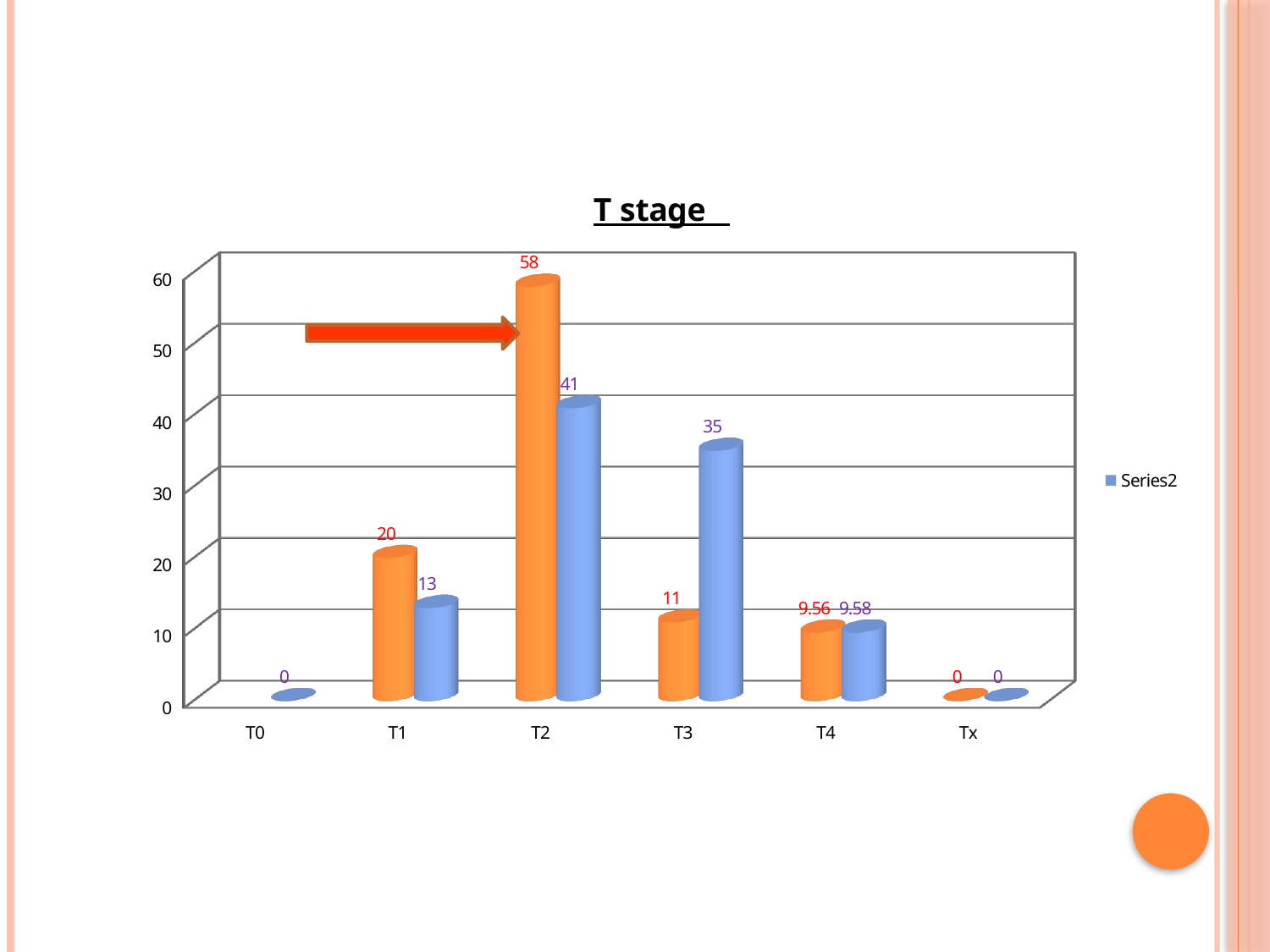
What is the value of the orange bar for T1? 20 Is the value of the orange bar for T2 greater or less than 50? greater What is the value of Series2 for T2? 41 How many categories are shown on the x axis? 6 What is the value of the orange bar for T4? 9.56 Which category has the highest Series2 value? T2 What type of chart is shown on the slide? bar chart What is the value of Series2 for T3? 35 What is the difference between the orange bar and the Series2 bar for T2? 17 For T3, which is larger: the orange bar or the Series2 bar? Series2 Which category has the highest orange bar? T2 How many series does the legend list? 1